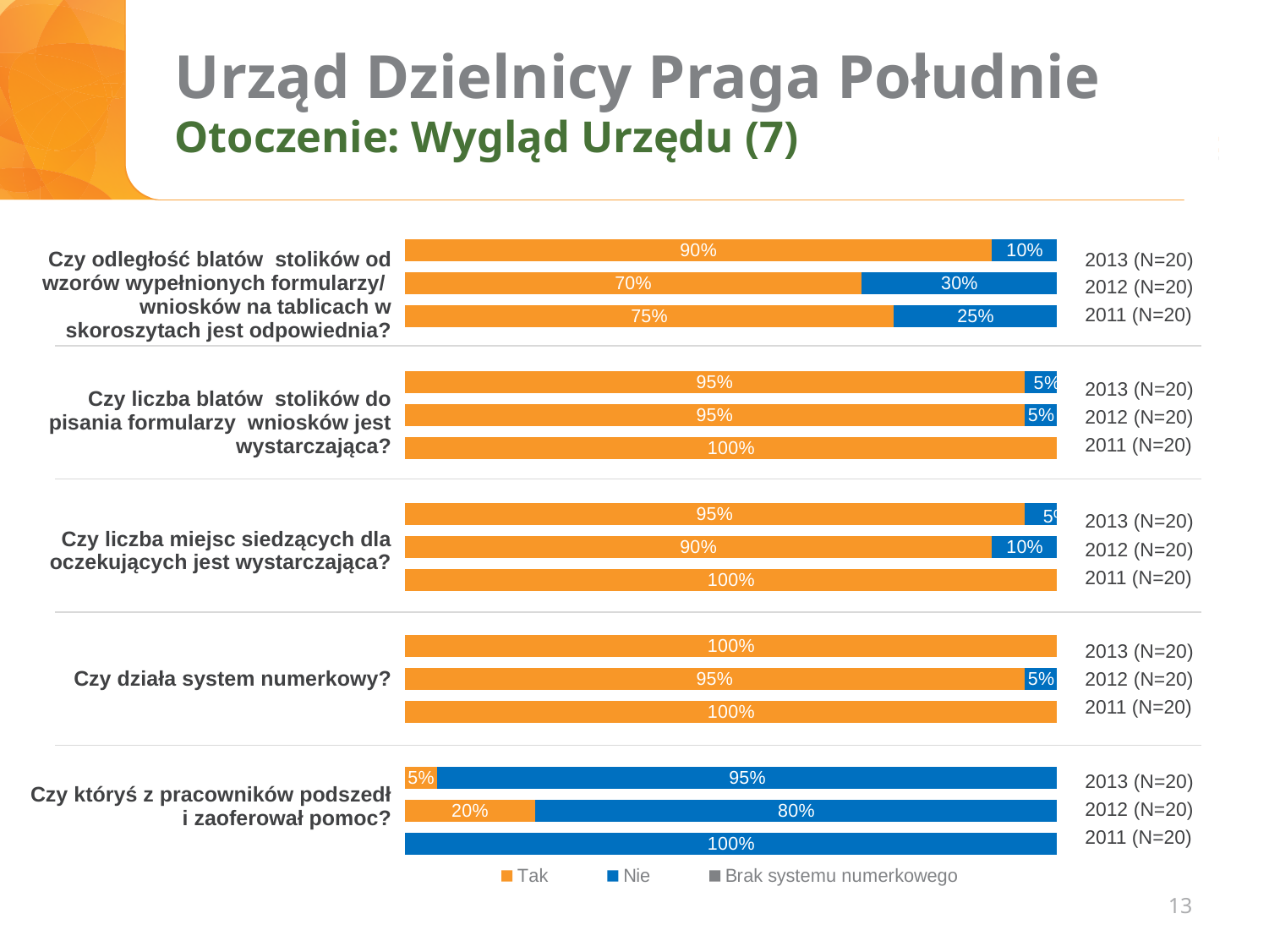
What kind of chart is used on this slide? Stacked bar chart In the chart for "Czy odległość blatów stolików od wzorów wypełnionych formularzy/wniosków na tablicach w skoroszytach jest odpowiednia?", what percentage answered "Tak" in 2013? 90% How many entries does the legend at the bottom of the slide list? 3 In the chart for "Czy odległość blatów stolików od wzorów wypełnionych formularzy/wniosków na tablicach w skoroszytach jest odpowiednia?", what is the difference between the "Tak" share in 2013 and in 2012? 20 percentage points In the chart for "Czy działa system numerkowy?", what percentage answered "Tak" in 2012? 95% In the chart for "Czy liczba blatów stolików do pisania formularzy wniosków jest wystarczająca?", what percentage answered "Tak" in 2011? 100% In the chart for "Czy odległość blatów stolików od wzorów wypełnionych formularzy/wniosków na tablicach w skoroszytach jest odpowiednia?", which year had the highest "Tak" share? 2013 In the chart for "Czy któryś z pracowników podszedł i zaoferował pomoc?", which year had the larger "Tak" share, 2013 or 2012? 2012 In the chart for "Czy liczba miejsc siedzących dla oczekujących jest wystarczająca?", what percentage answered "Nie" in 2012? 10% In the chart for "Czy odległość blatów stolików od wzorów wypełnionych formularzy/wniosków na tablicach w skoroszytach jest odpowiednia?", what percentage answered "Nie" in 2012? 30% In the chart for "Czy któryś z pracowników podszedł i zaoferował pomoc?", what percentage answered "Nie" in 2013? 95% What is the sample size (N) shown for each year on the slide? N=20